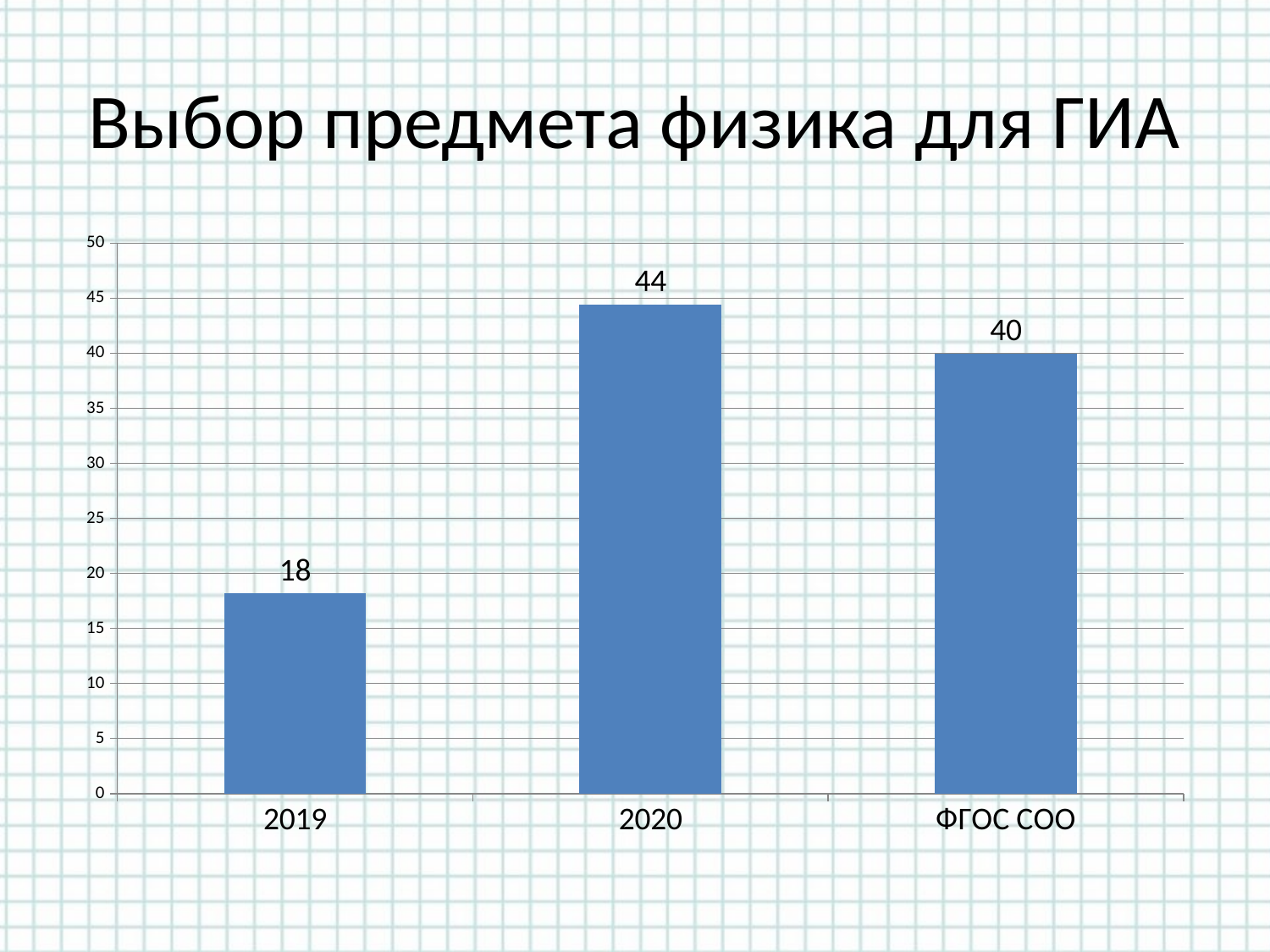
What is the value for 2019? 18 What is the value for ФГОС СОО? 40 Is the value for 2019 greater or less than 20? less How many categories are shown on the x axis? 3 What kind of chart is shown on the slide? bar chart What is the title of the slide? Выбор предмета физика для ГИА Which category has the highest value? 2020 What is the difference between the values for 2020 and 2019? 26 Which category has the lowest value? 2019 What is the difference between the values for 2020 and ФГОС СОО? 4 Which is larger, the value for 2019 or the value for ФГОС СОО? ФГОС СОО What is the value for 2020? 44